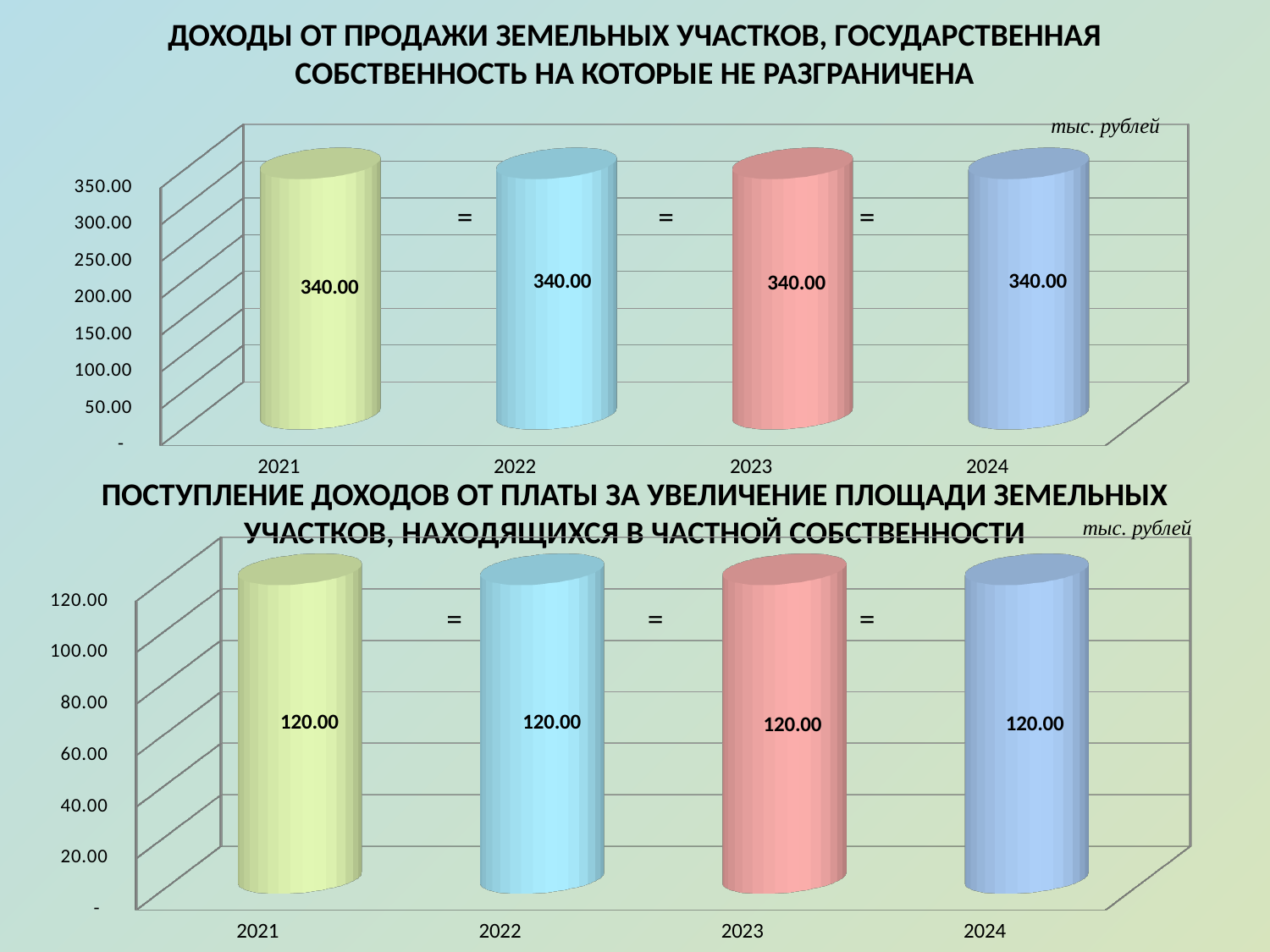
In the top chart (Доходы от продажи земельных участков), what is the value for 2021? 340.00 In the bottom chart (Поступление доходов от платы за увеличение площади земельных участков), what is the value for 2023? 120.00 What unit is indicated in the top right corner of the top chart? тыс. рублей In the top chart (Доходы от продажи земельных участков), what is the value for 2024? 340.00 What kind of chart is the top chart? Bar chart In the top chart, do the values rise, fall or stay the same from 2021 to 2024? Stay the same In the bottom chart, do the values rise, fall or stay the same from 2021 to 2024? Stay the same In the bottom chart, how many categories are plotted? 4 In the bottom chart (Поступление доходов от платы за увеличение площади земельных участков), what is the value for 2022? 120.00 In the bottom chart, what is the difference between the values for 2024 and 2021? 0.00 In the top chart, what is the difference between the values for 2023 and 2021? 0.00 In the top chart, how many years are shown on the x axis? 4